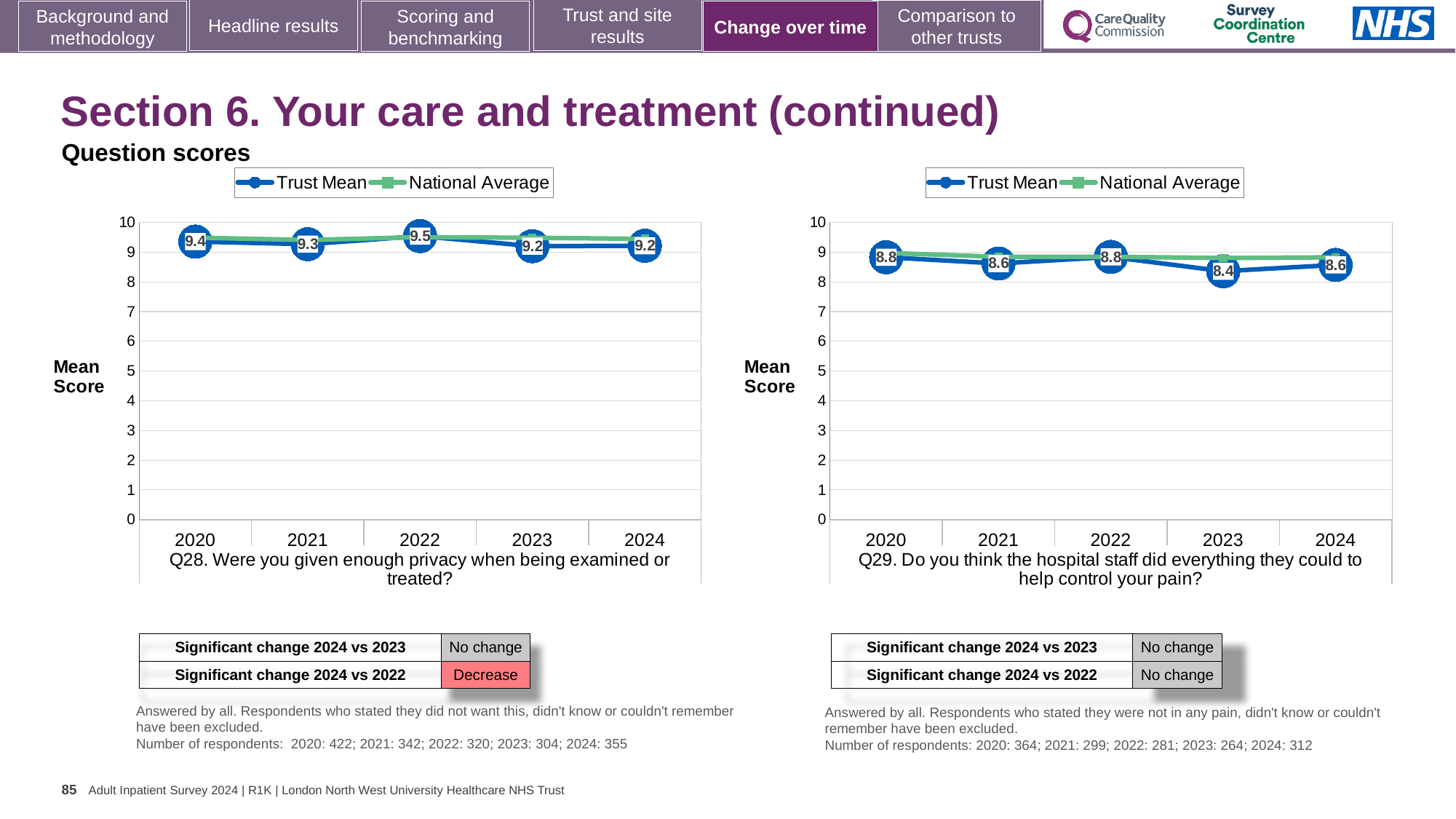
What kind of chart is used for Q28? Line chart In the Q28 chart, what is the difference between the Trust Mean scores for 2022 and 2024? 0.3 In the Q29 chart, what is the Trust Mean score for 2023? 8.4 In the Q28 chart, what is the Trust Mean score for 2022? 9.5 In the Q29 chart, what is the difference between the Trust Mean scores for 2020 and 2023? 0.4 In the Q29 chart, is the National Average value for 2023 greater or less than 8? greater How many years are shown on the x axis of the Q28 chart? 5 What is the label on the y axis of the Q29 chart? Mean Score In the Q29 chart, which year has the lowest Trust Mean score? 2023 How many series does the legend of the Q29 chart list? 2 In the Q28 chart, which year has the highest Trust Mean score? 2022 In the Q29 chart, which year has the larger Trust Mean score, 2021 or 2023? 2021